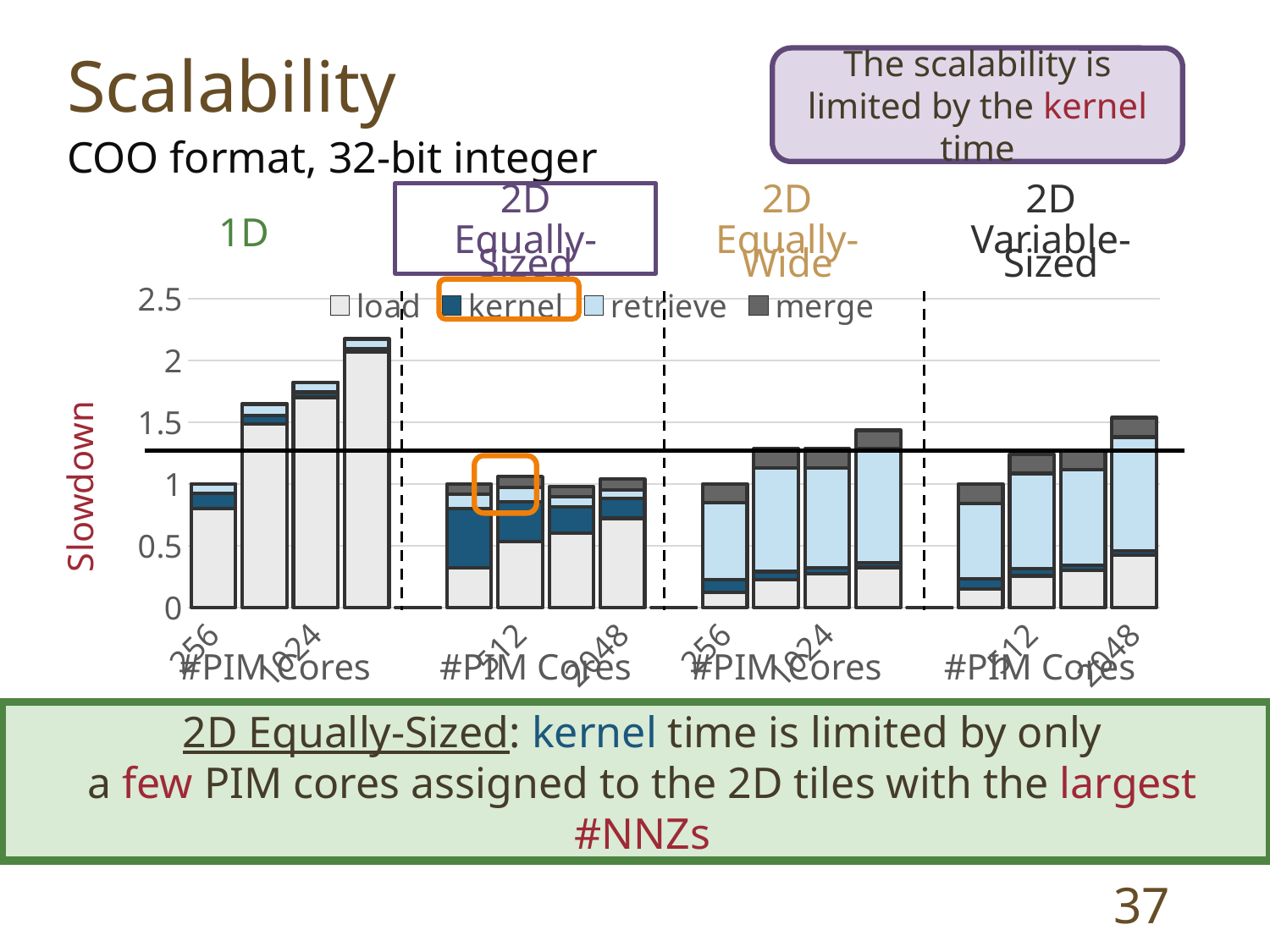
Is the total slowdown for 1D at 512 PIM cores greater or less than 1.5? greater Which group contains the tallest bar in the chart? 1D Which is larger at 2048 PIM cores: the total slowdown for 1D or for 2D Equally-Sized? 1D What is the label of the y axis? Slowdown In the 1D group, does the total slowdown rise or fall as the number of PIM cores increases? rise Is the total slowdown for 1D at 2048 PIM cores greater or less than 2? greater How many series does the chart legend list? 4 How many bars are in the 1D group of the chart? 4 What are the series names listed in the chart legend? load, kernel, retrieve, merge Is the total slowdown for 2D Equally-Sized at 2048 PIM cores greater or less than 1.5? less How many groups of bars (partitioning schemes) are shown in the chart? 4 What kind of chart is shown on the slide? stacked bar chart